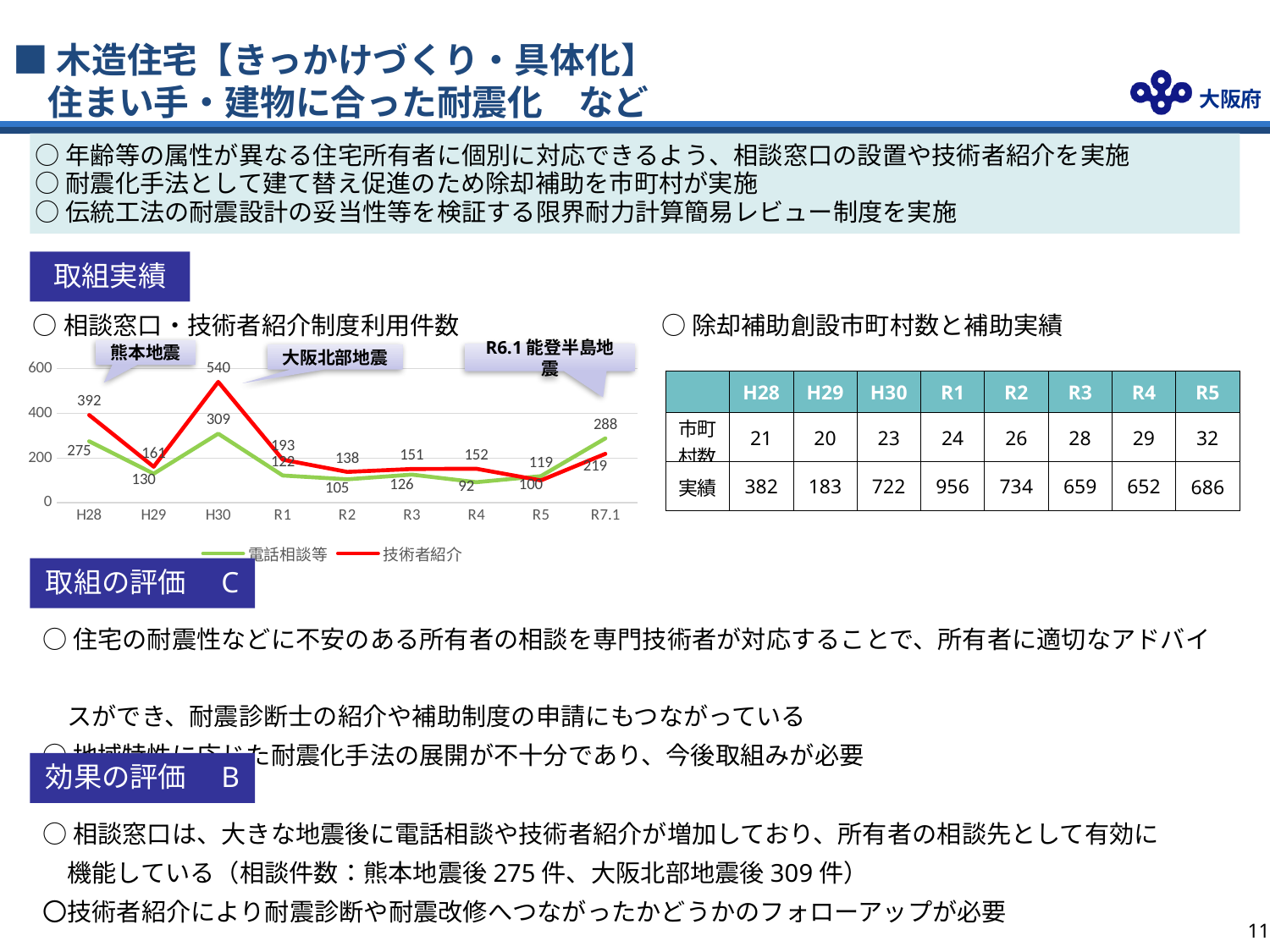
How many series does the chart legend list? 2 Which is larger for R7.1, 技術者紹介 or 電話相談等? 電話相談等 In which category is 技術者紹介 highest? H30 What kind of chart is shown on the slide? line chart What is the value of 技術者紹介 for H30? 540 What is the value of 電話相談等 for R7.1? 288 How many categories are plotted along the x axis of the chart? 9 What is the difference between 技術者紹介 and 電話相談等 for H30? 231 Which series is drawn in red in the chart? 技術者紹介 Do the values of 技術者紹介 rise or fall from H30 to R1? fall What is the value of 電話相談等 for H28? 275 In which category is 電話相談等 lowest? R4